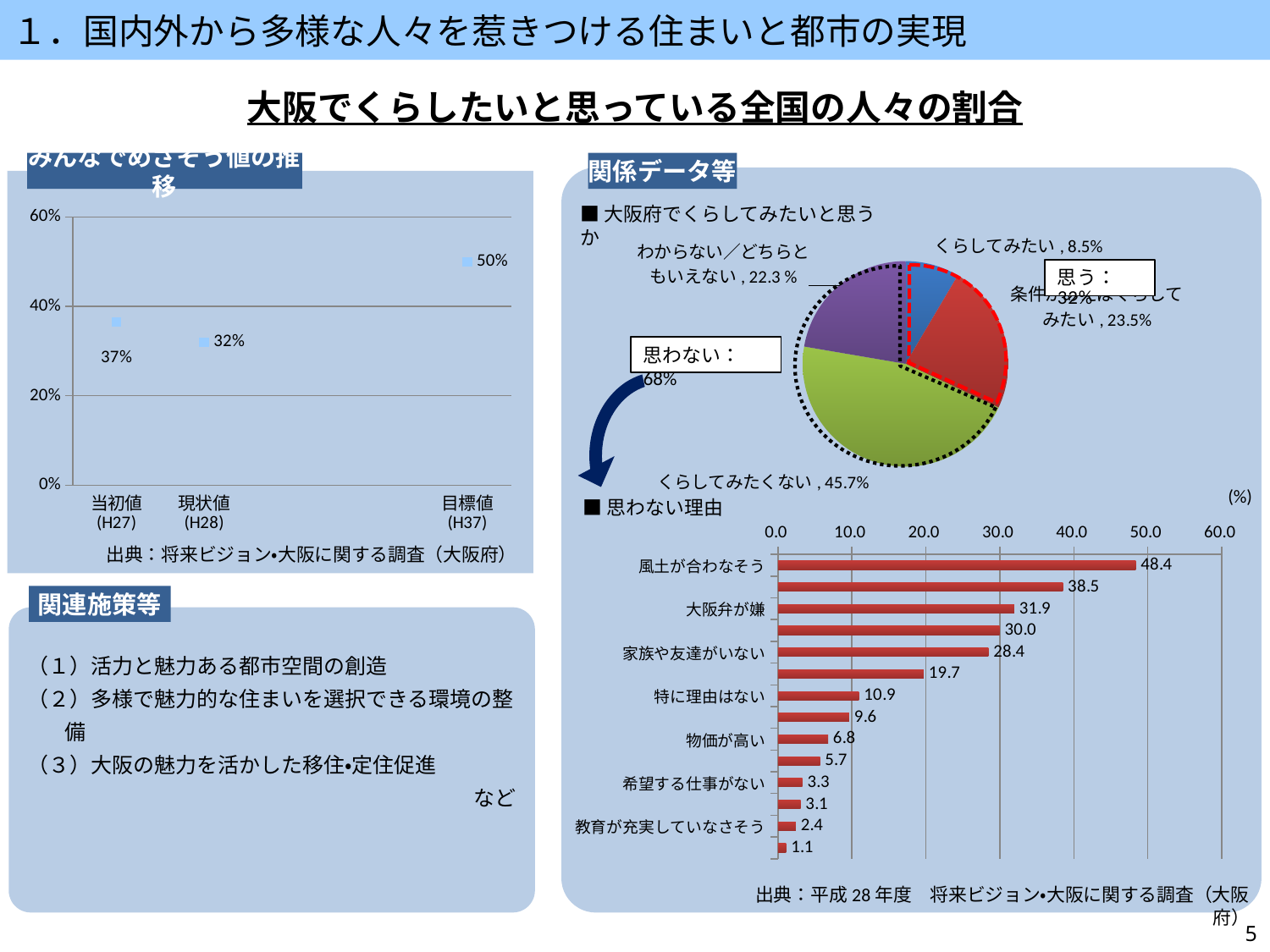
In the left chart titled みんなでめざそう値の推移, which category has the lowest value? 現状値 (H28) In the pie chart 大阪府でくらしてみたいと思うか, what percentage is shown for 思わない? 68% What kind of chart is the 思わない理由 chart? bar chart In the bar chart 思わない理由, which is larger, 大阪弁が嫌 or 物価が高い? 大阪弁が嫌 In the pie chart 大阪府でくらしてみたいと思うか, what share is 条件が合えばくらしてみたい? 23.5% In the left chart titled みんなでめざそう値の推移, what is the value for 当初値 (H27)? 37% In the left chart titled みんなでめざそう値の推移, what is the value for 目標値 (H37)? 50% In the pie chart 大阪府でくらしてみたいと思うか, what share is くらしてみたくない? 45.7% In the bar chart 思わない理由, what is the value for 家族や友達がいない? 28.4 In the bar chart 思わない理由, what is the value for 風土が合わなそう? 48.4 In the left chart titled みんなでめざそう値の推移, what is the difference between the 目標値 (H37) and the 現状値 (H28)? 18% In the pie chart 大阪府でくらしてみたいと思うか, which slice is the smallest? くらしてみたい